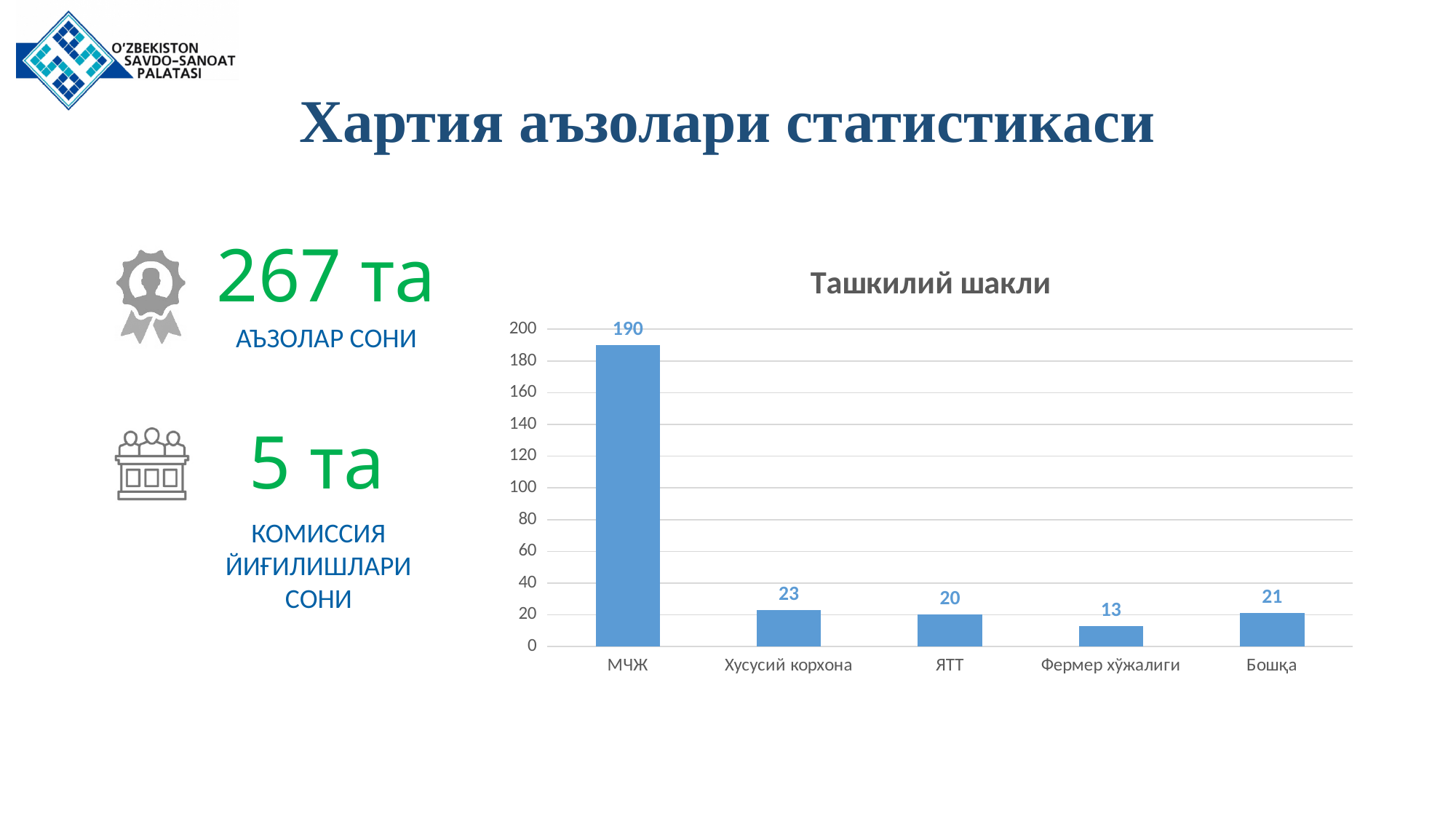
What is the value for Хусусий корхона? 23 What is the title of the chart? Ташкилий шакли Which is larger, the value for Хусусий корхона or the value for ЯТТ? Хусусий корхона What is the value for Бошқа? 21 How many categories are shown on the x axis of the chart? 5 Which category has the lowest value? Фермер хўжалиги Which category has the highest value? МЧЖ What is the value for МЧЖ in the chart? 190 What is the difference between the values for МЧЖ and Хусусий корхона? 167 What is the difference between the values for Бошқа and ЯТТ? 1 What is the value for Фермер хўжалиги? 13 Is the value for МЧЖ greater or less than 180? greater